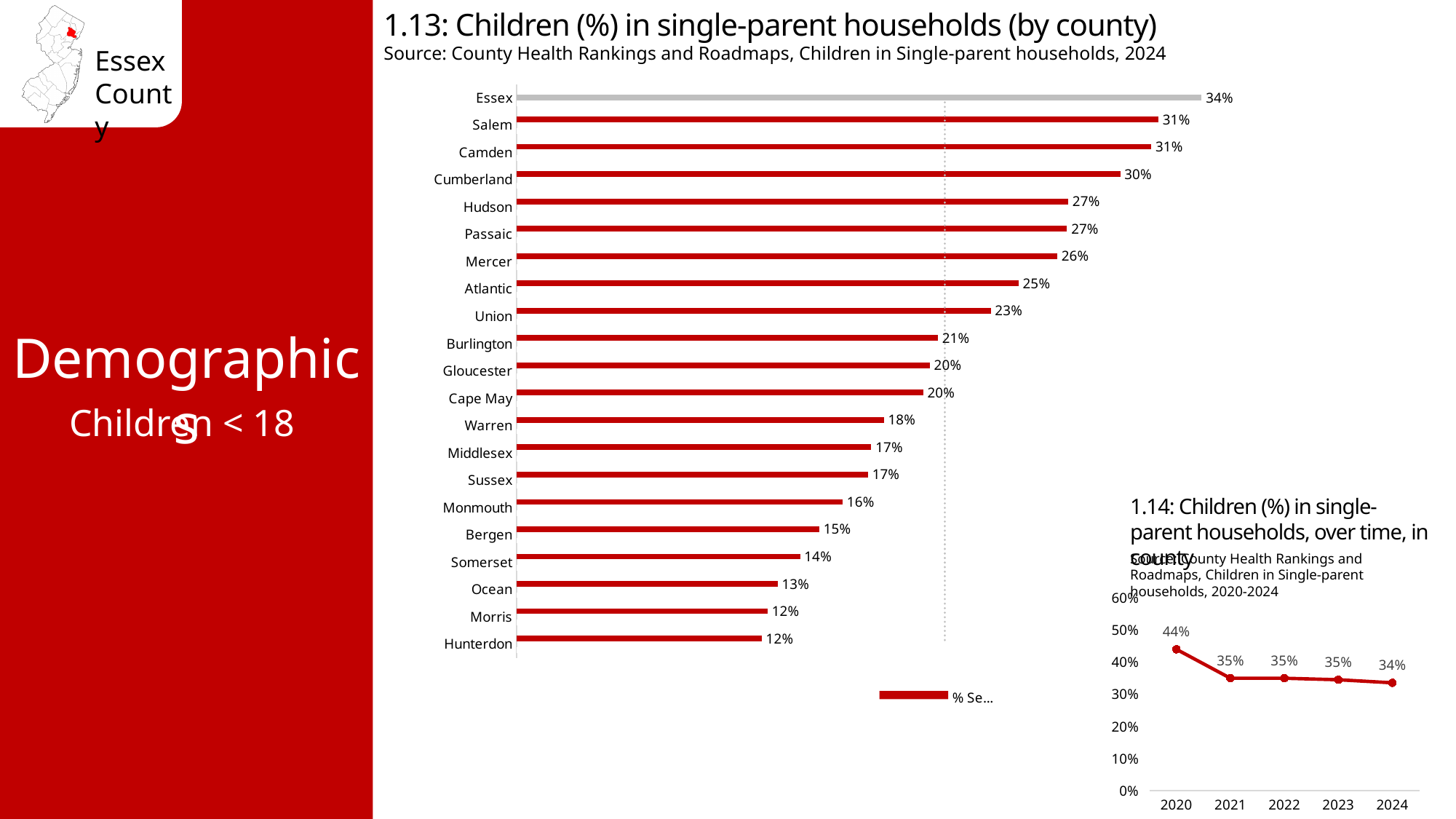
In chart 1.14, what is the value for 2024? 34% In chart 1.13, what percentage of children in Hudson County live in single-parent households? 27% What type of chart is chart 1.13? Bar chart In chart 1.13, which county has the lowest value? Morris and Hunterdon (tied at 12%) How many years are plotted in chart 1.14? 5 In chart 1.13, which county has the highest value? Essex In chart 1.14, do the values rise or fall from 2020 to 2024? Fall How many counties are shown in chart 1.13? 21 In chart 1.13, what is the difference between the values for Essex and Hunterdon? 22% In chart 1.13, which county has a higher value, Union or Bergen? Union In chart 1.14 (Children in single-parent households over time in county), what is the value for 2020? 44% In chart 1.13 (Children in single-parent households by county), what is the value for Essex? 34%